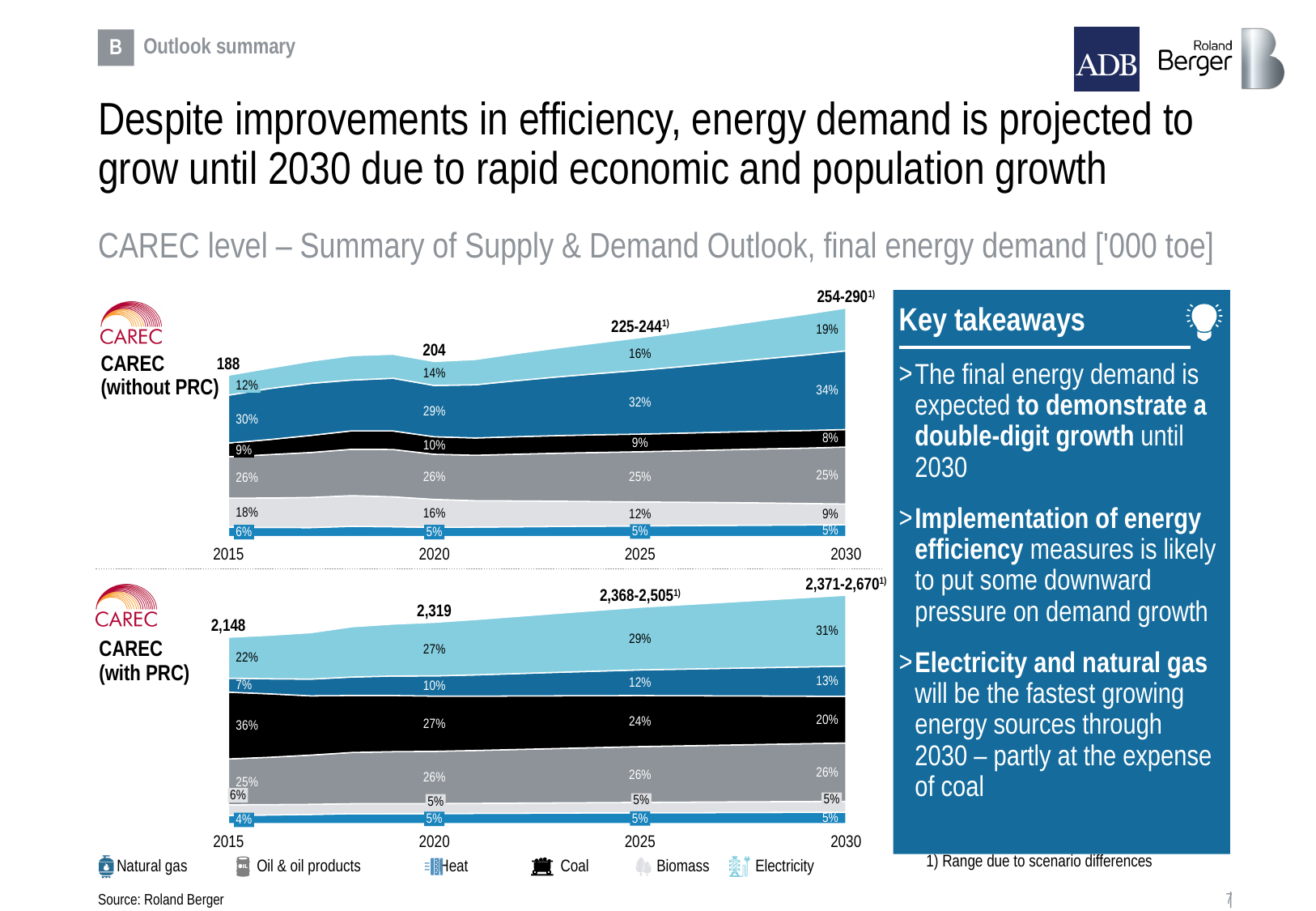
In the CAREC (with PRC) chart, what share does coal (the black layer) have in 2015? 36% In the CAREC (with PRC) chart, does total final energy demand rise or fall from 2015 to 2030? rise What kind of chart is used for the CAREC (without PRC) energy demand data? stacked area chart In the CAREC (without PRC) chart, by how much does the total rise from 2015 to 2020? 16 In the CAREC (without PRC) chart, what range is shown for total final energy demand in 2030? 254-290 Which is larger in 2015: the total for CAREC (with PRC) or CAREC (without PRC)? CAREC (with PRC) In the CAREC (without PRC) chart, what is the total final energy demand in 2015? 188 How many years are shown on the x axis of each chart? 4 In the CAREC (with PRC) chart, what is the total final energy demand in 2020? 2,319 In the CAREC (with PRC) chart, what range is shown for total final energy demand in 2025? 2,368-2,505 In the CAREC (with PRC) chart, what is the difference between the 2020 total and the 2015 total? 171 How many energy sources does the legend list? 6